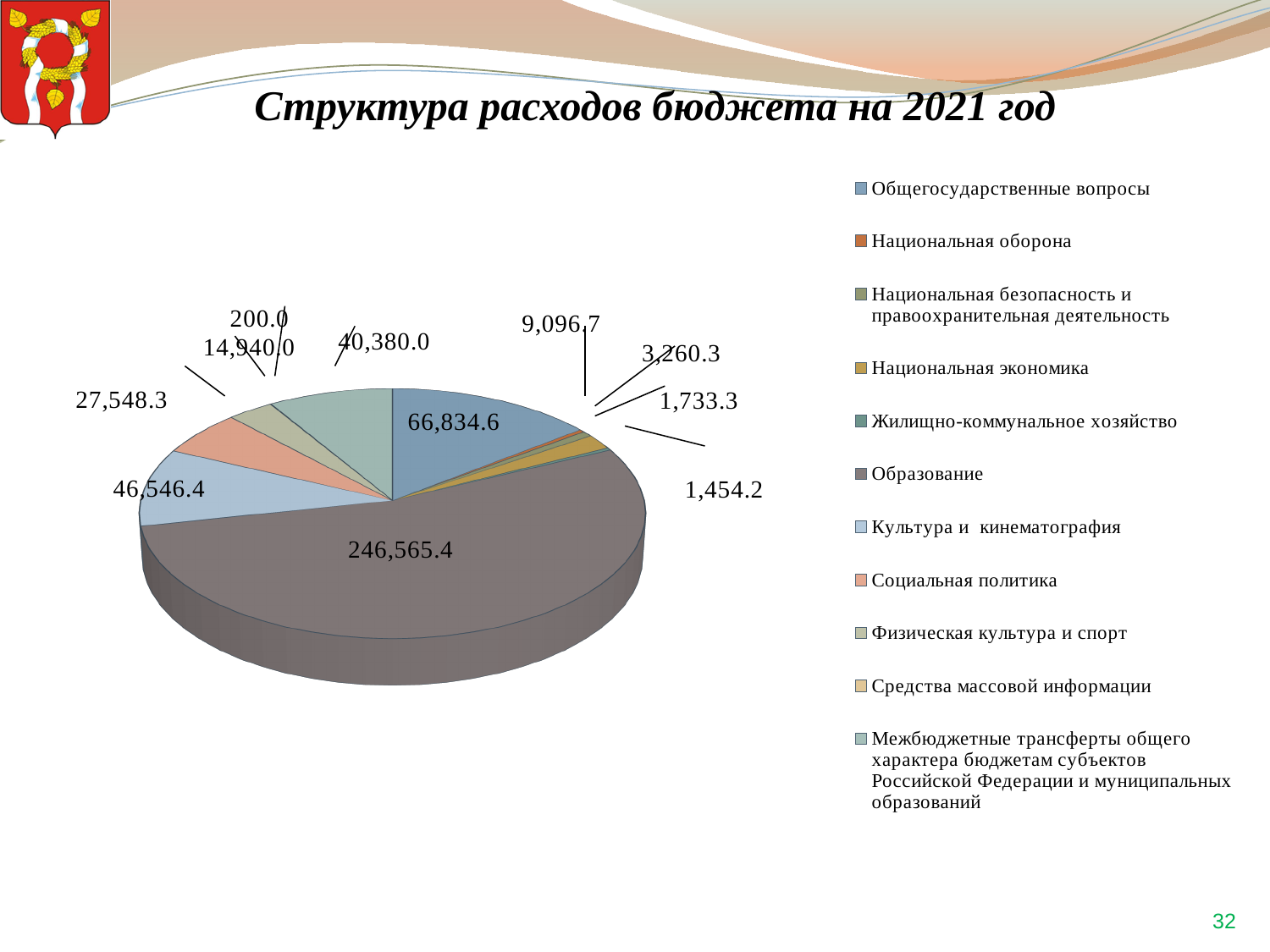
What is the value shown for Образование? 246,565.4 What is the difference between the values for Общегосударственные вопросы and Культура и кинематография? 20,288.2 What is the value shown for Межбюджетные трансферты общего характера бюджетам субъектов Российской Федерации и муниципальных образований? 40,380.0 What is the value shown for Культура и кинематография? 46,546.4 What is the title of the chart? Структура расходов бюджета на 2021 год What type of chart is shown on the slide? Pie chart How many categories does the legend of the pie chart list? 11 Which is larger: the value for Культура и кинематография or the value for Межбюджетные трансферты? Культура и кинематография Which category has the smallest value in the pie chart? Средства массовой информации What is the value shown for Общегосударственные вопросы? 66,834.6 Which category has the largest slice of the pie? Образование What is the value shown for Социальная политика? 27,548.3